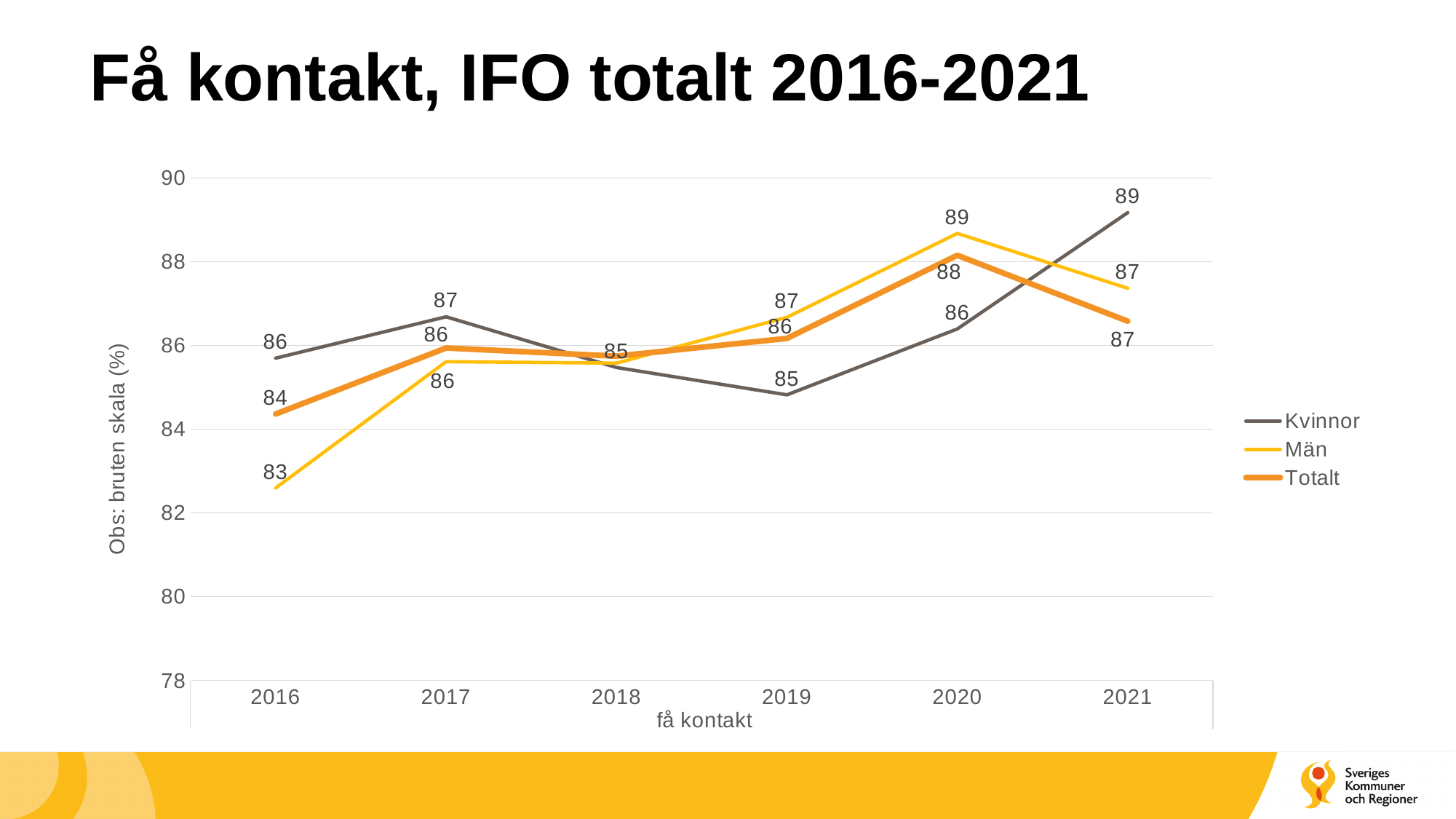
In which year is the value for Män lowest? 2016 How many years are shown on the x axis? 6 What kind of chart is shown on the slide? line chart What is the value for Män in 2016? 83 What is the label on the y axis? Obs: bruten skala (%) What is the difference between the Män value in 2020 and the Män value in 2016? 6 In which year is the value for Män highest? 2020 How many series does the legend list? 3 What is the value for Totalt in 2020? 88 What is the value for Kvinnor in 2021? 89 In 2016, which is larger, the value for Kvinnor or the value for Män? Kvinnor In which year is the value for Kvinnor highest? 2021